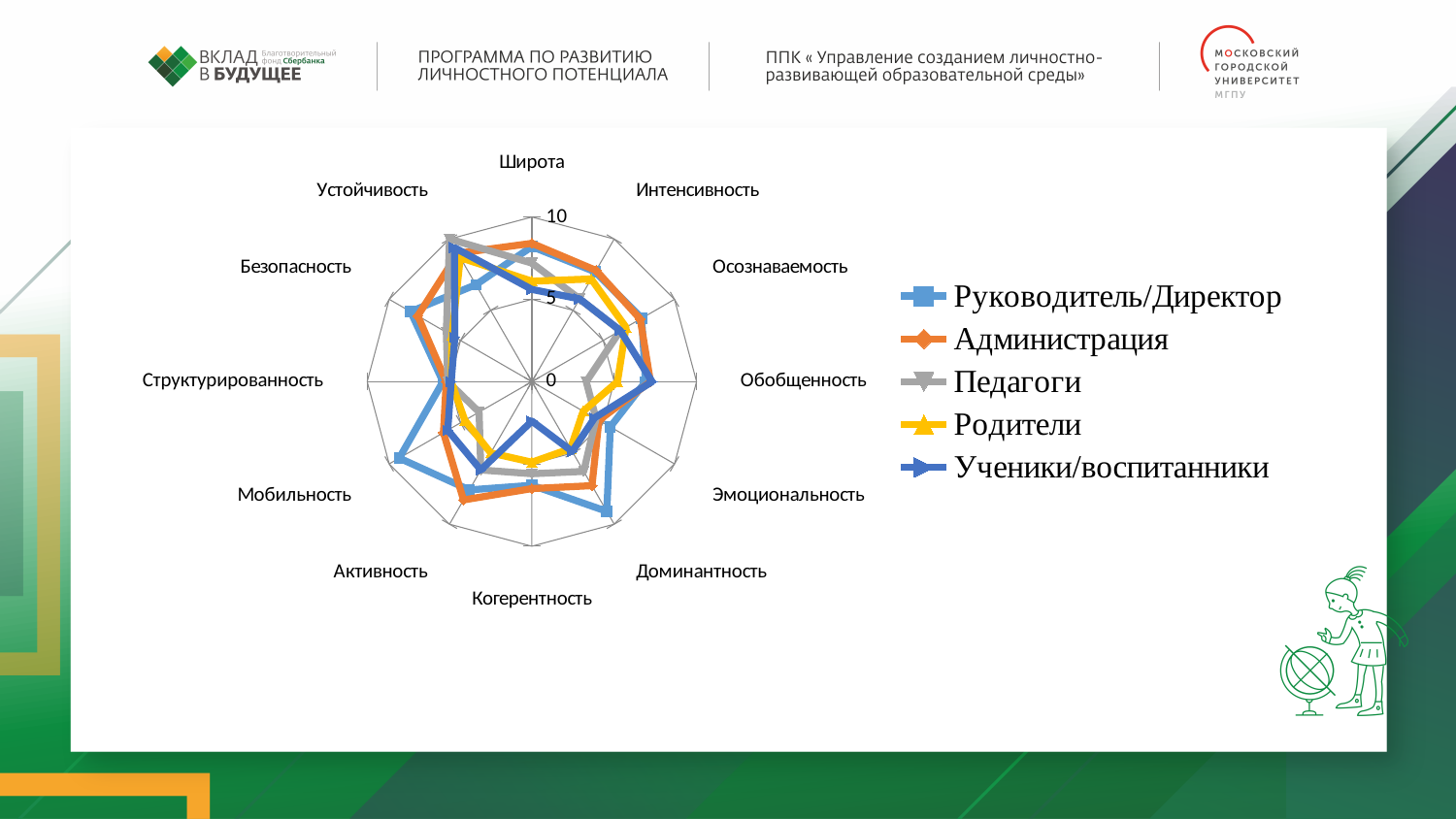
What kind of chart is shown on the slide? radar chart Is the value for Руководитель/Директор on the Доминантность axis greater or less than 5? greater How many categories (axes) does the radar chart have? 12 Is the value for Руководитель/Директор on the Мобильность axis greater or less than 5? greater Which series is listed first in the legend? Руководитель/Директор Is the value for Администрация on the Широта axis greater or less than 5? greater What is the maximum value shown on the radar chart's axis scale? 10 How many series does the legend list? 5 What colour is the line for the Администрация series? orange